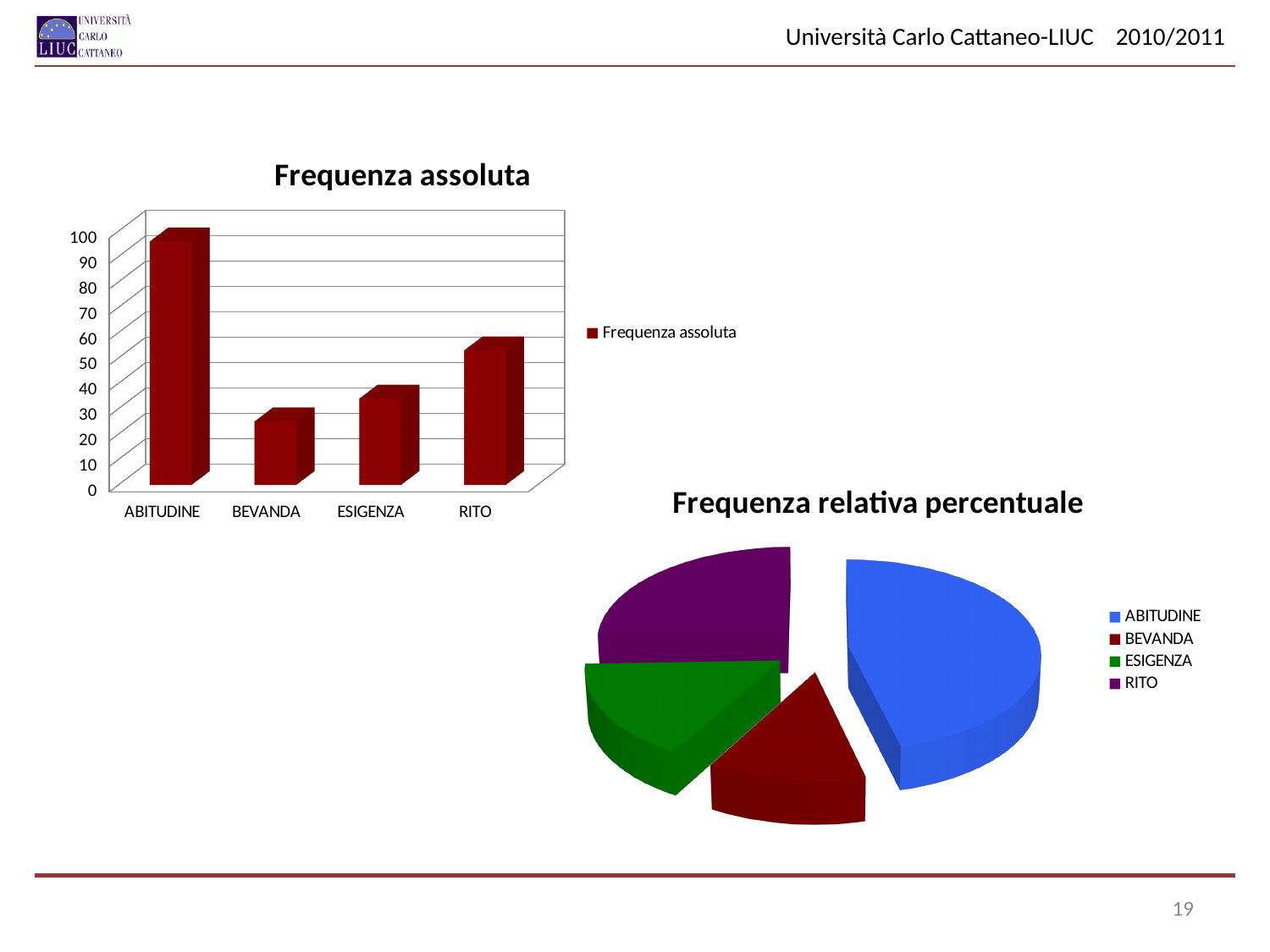
In the 'Frequenza assoluta' chart, how many categories are shown on the x axis? 4 In the 'Frequenza assoluta' chart, which is larger, the value for RITO or the value for ESIGENZA? RITO In the 'Frequenza assoluta' chart, which category has the highest value? ABITUDINE In the 'Frequenza assoluta' chart, what kind of chart is shown? bar chart In the 'Frequenza assoluta' chart, how many series does the legend list? 1 In the 'Frequenza assoluta' chart, is the value for RITO greater or less than 50? greater In the 'Frequenza relativa percentuale' chart, what kind of chart is shown? pie chart In the 'Frequenza assoluta' chart, is the value for BEVANDA greater or less than 30? less In the 'Frequenza relativa percentuale' chart, how many slices does the pie have? 4 In the 'Frequenza relativa percentuale' chart, which category is shown in blue according to the legend? ABITUDINE In the 'Frequenza assoluta' chart, is the value for ABITUDINE greater or less than 90? greater In the 'Frequenza assoluta' chart, which category has the lowest value? BEVANDA